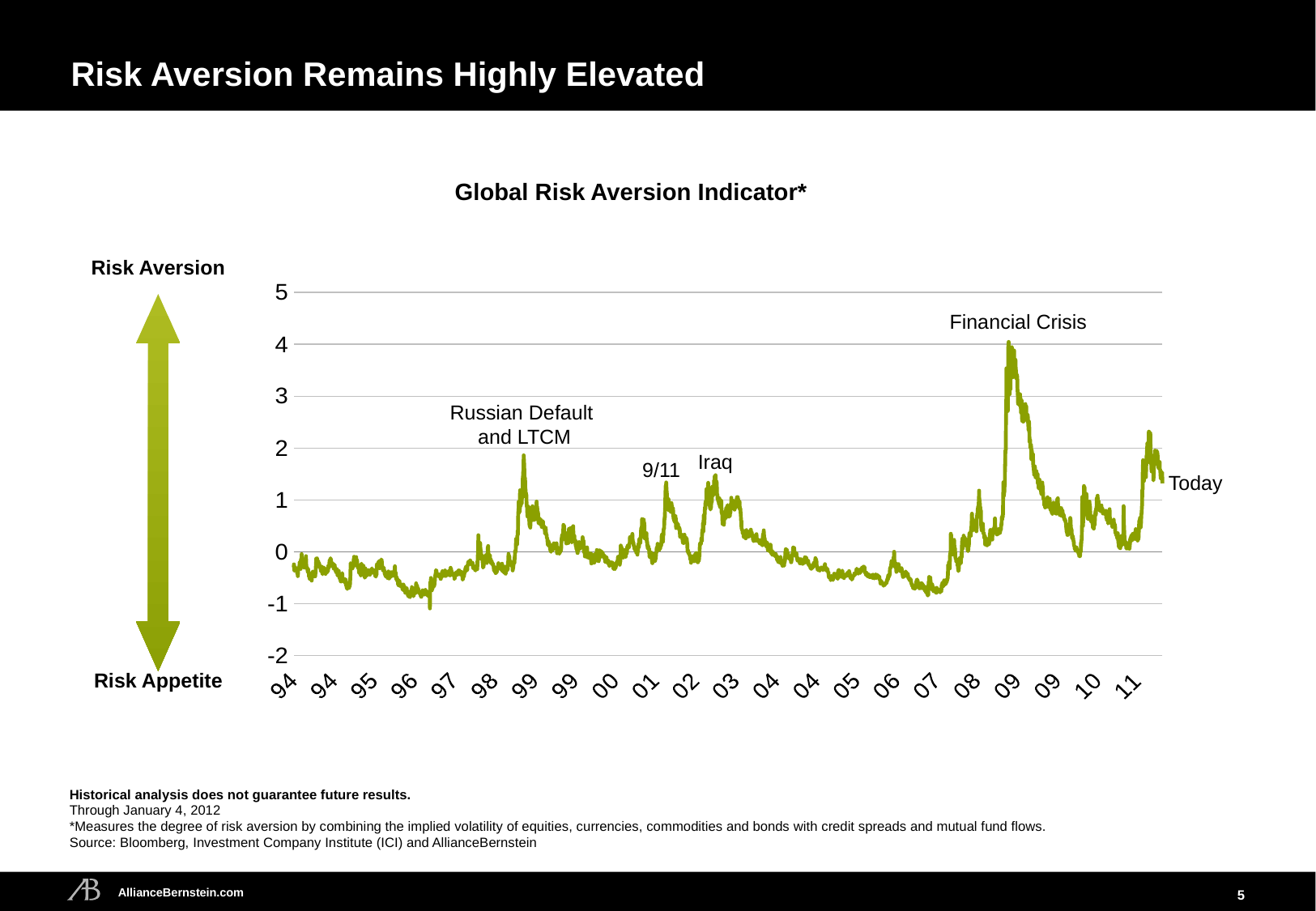
Is the value of the indicator labelled "Today" greater or less than 2? less Which peak is higher: the Financial Crisis or the Russian Default and LTCM? Financial Crisis Which annotated event corresponds to the highest peak of the Global Risk Aversion Indicator? Financial Crisis Which peak is higher: the Russian Default and LTCM or 9/11? Russian Default and LTCM Is the value of the indicator labelled "Today" greater or less than 1? greater Is the peak of the indicator at the Financial Crisis greater or less than 3? greater What is the title of the chart? Global Risk Aversion Indicator* What do the labels at the top and bottom of the arrow to the left of the chart say? Risk Aversion (top) and Risk Appetite (bottom) What kind of chart is shown on the slide? Line chart Does the indicator rise or fall between its Financial Crisis peak in 2009 and 2010? fall How many lines are plotted on the chart? 1